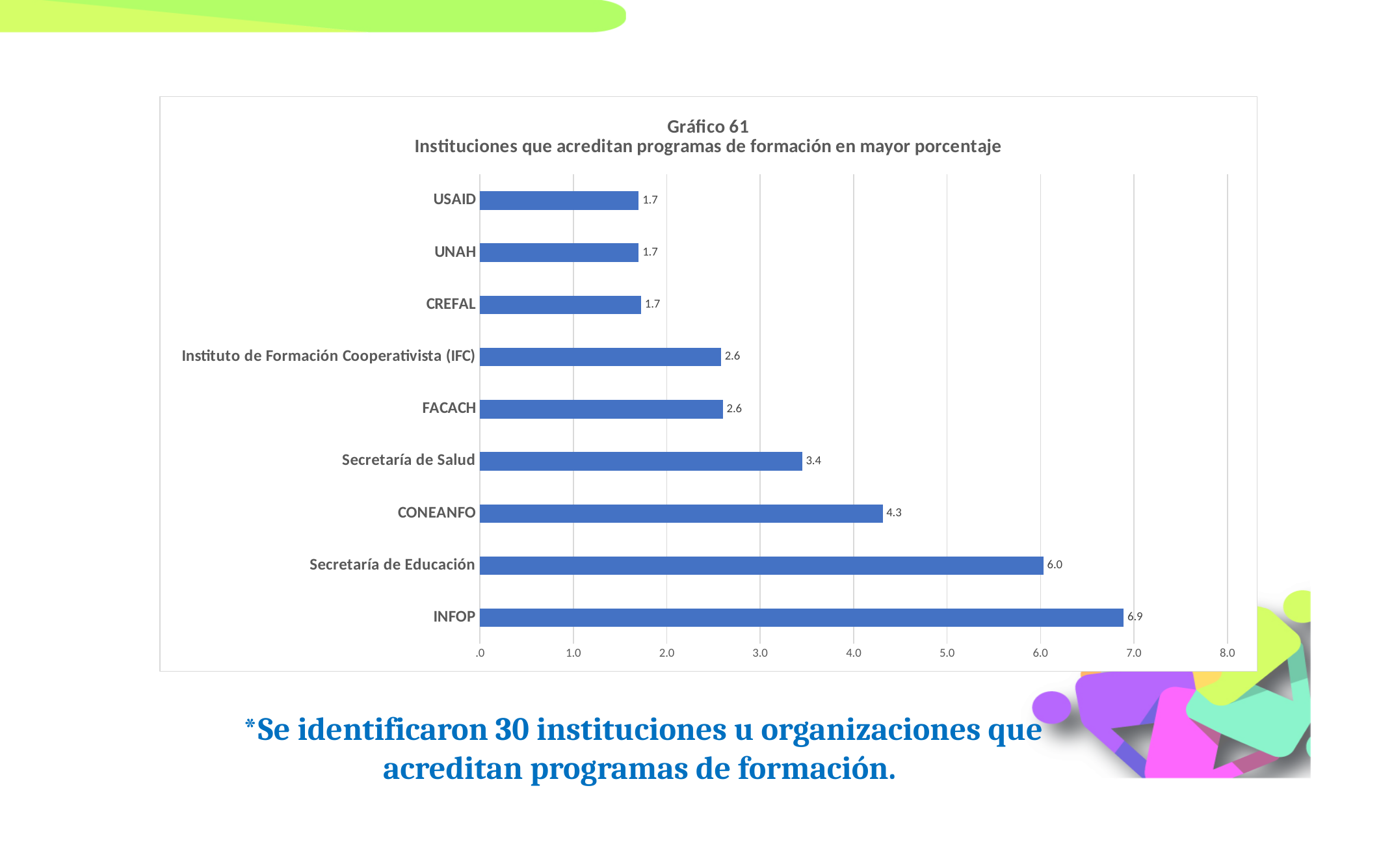
Which is larger, the value for FACACH or the value for Secretaría de Salud? Secretaría de Salud What is the value for Secretaría de Educación? 6.0 How many institutions are shown in the chart? 9 What kind of chart is shown on the slide? bar chart What is the difference between the values for CONEANFO and Secretaría de Salud? 0.9 What is the value for Secretaría de Salud? 3.4 Is the value for Secretaría de Educación greater or less than 5.0? greater What is the number of the chart given in its title? Gráfico 61 What is the value for CONEANFO? 4.3 What is the value for INFOP? 6.9 What is the difference between the values for INFOP and Secretaría de Educación? 0.9 Which institution has the highest value? INFOP